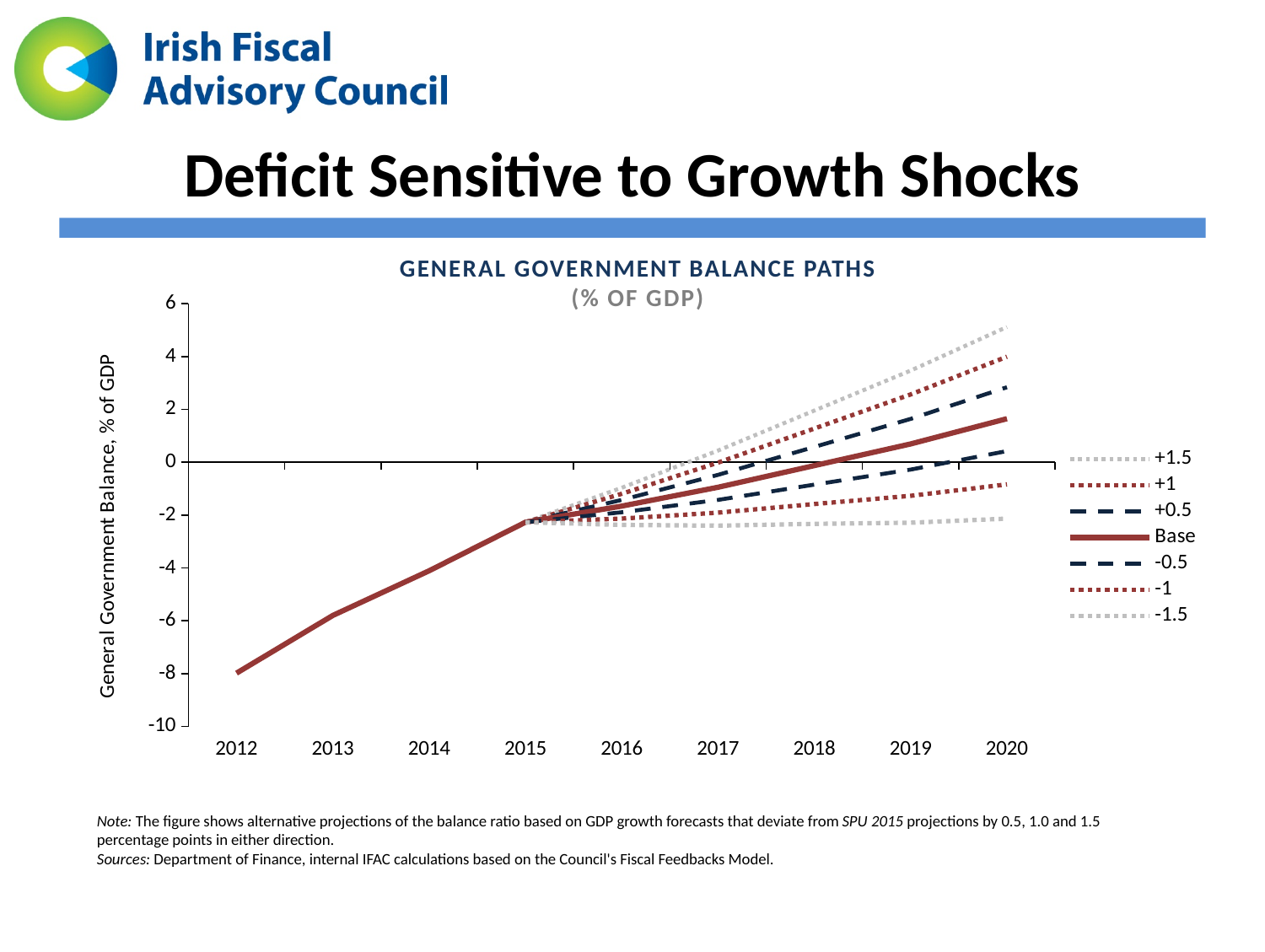
Is the value for the +1.5 series in 2020 greater or less than 4? greater In 2020, which series has the larger value, +1 or -1? +1 How many series does the legend list? 7 What kind of chart is shown on the slide? Line chart Is the value for the Base series in 2020 greater or less than 2? less Which series has the highest value in 2020? +1.5 Is the value for the Base series in 2020 greater or less than 0? greater Does the Base series rise or fall from 2012 to 2020? Rise What is the title of the chart? General Government Balance Paths (% of GDP) Which series has the lowest value in 2020? -1.5 How many years are shown on the x axis? 9